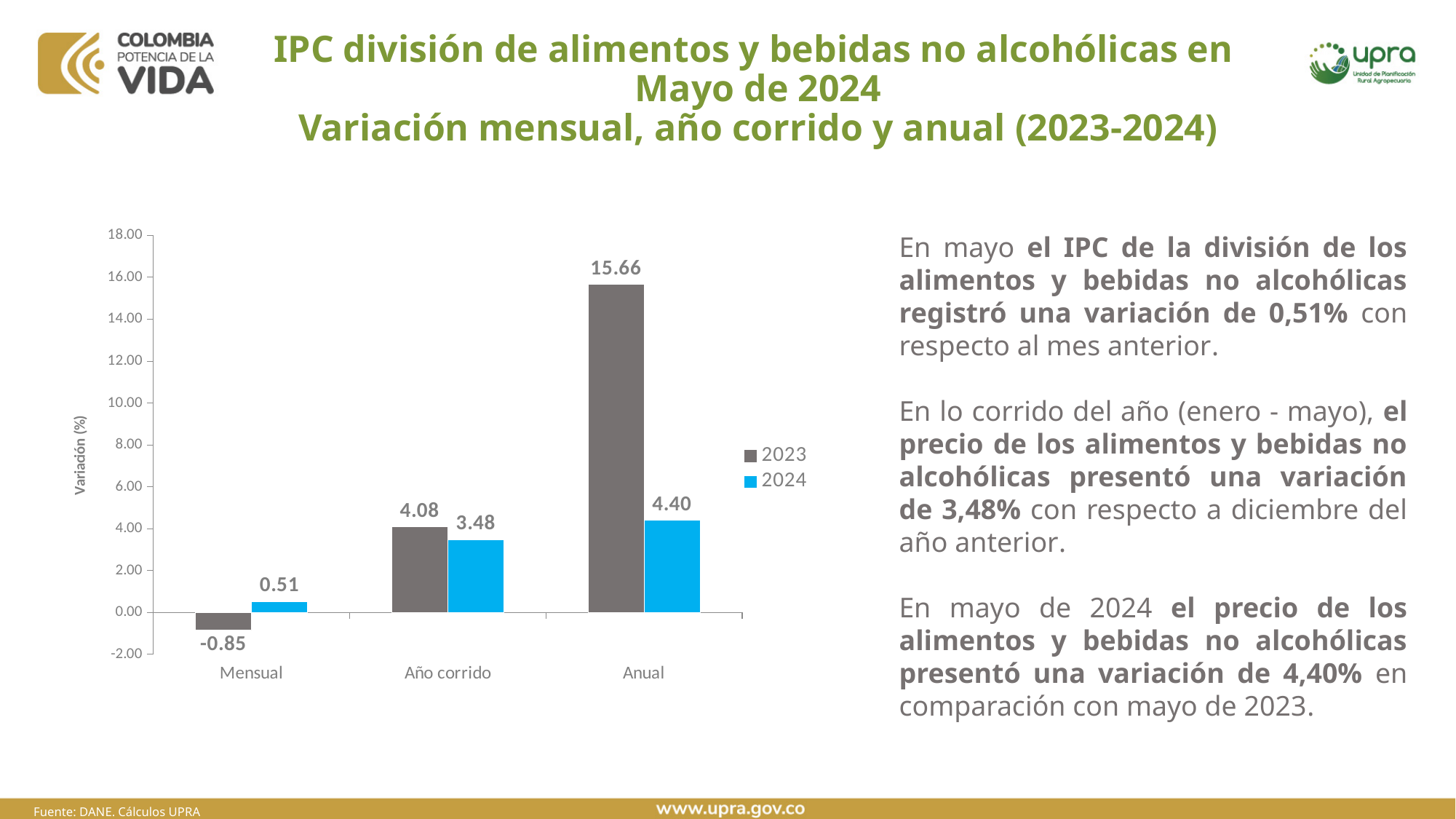
What is the value for 2024 in the Mensual category? 0.51 What kind of chart is shown on the slide? Bar chart Which category has the highest value for the 2023 series? Anual How many series does the legend list? 2 What is the difference between the 2023 and 2024 values in the Anual category? 11.26 What is the value for 2024 in the Año corrido category? 3.48 Which category has the lowest value for the 2024 series? Mensual What is the value for 2023 in the Mensual category? -0.85 What is the label of the vertical axis? Variación (%) What is the value for 2023 in the Anual category? 15.66 In the Año corrido category, which series has the larger value, 2023 or 2024? 2023 How many categories are shown on the x axis? 3